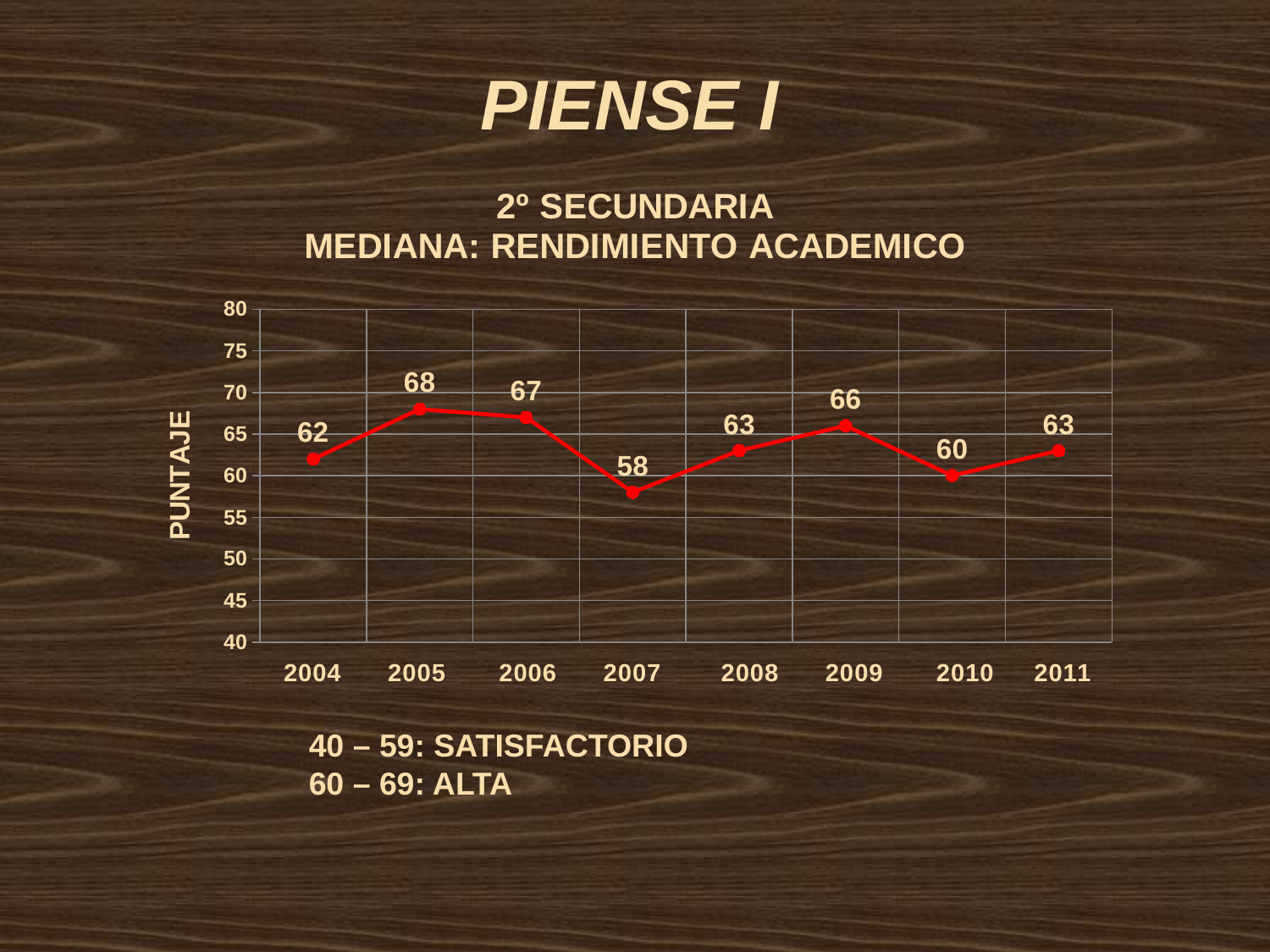
What is the label on the vertical axis? PUNTAJE Which year has the lowest value? 2007 What is the value for 2010? 60 Which is larger, the value for 2006 or the value for 2009? 2006 What is the value for 2007? 58 How many years are plotted on the chart? 8 What kind of chart is shown? line chart What is the difference between the values for 2005 and 2007? 10 Which year has the highest value? 2005 Does the value rise or fall from 2009 to 2010? fall What is the value for 2004? 62 Is the value for 2007 greater or less than 60? less